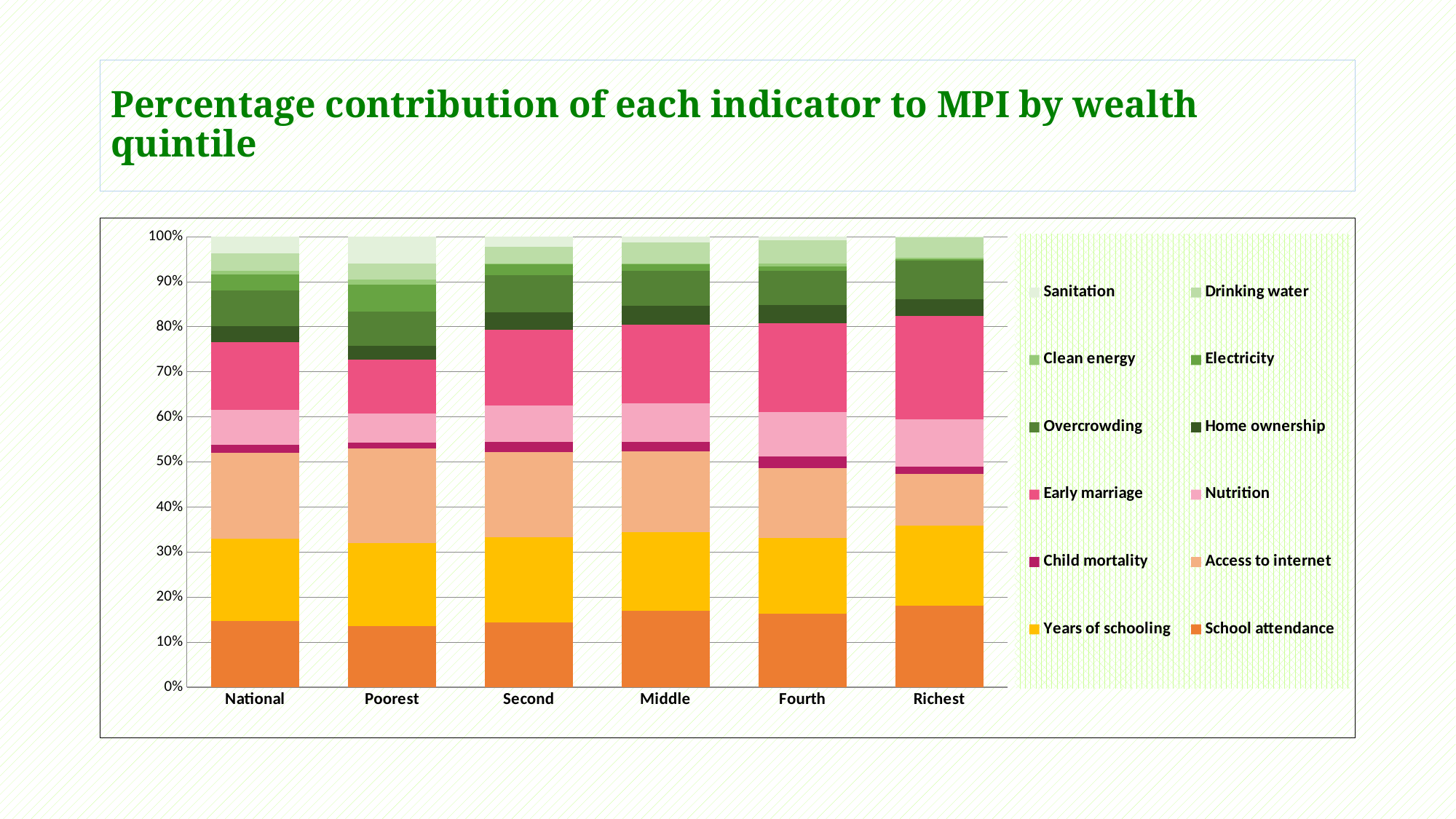
Is the School attendance segment for Richest greater or less than 10%? greater How many wealth quintile categories (including National) are shown on the x axis? 6 Is the Early marriage segment for Richest larger than the Early marriage segment for Poorest? Yes Which indicator forms the bottom segment of each stacked bar? School attendance Does the Early marriage segment rise or fall from Poorest to Richest? rise What kind of chart is shown on the slide? Stacked bar chart How many indicator series does the legend list? 12 Which category has the smallest Sanitation segment? Richest What is the total height of each stacked bar? 100% Is the School attendance segment for Poorest greater or less than 20%? less What is the title of the chart? Percentage contribution of each indicator to MPI by wealth quintile Which category has the largest Sanitation segment? Poorest